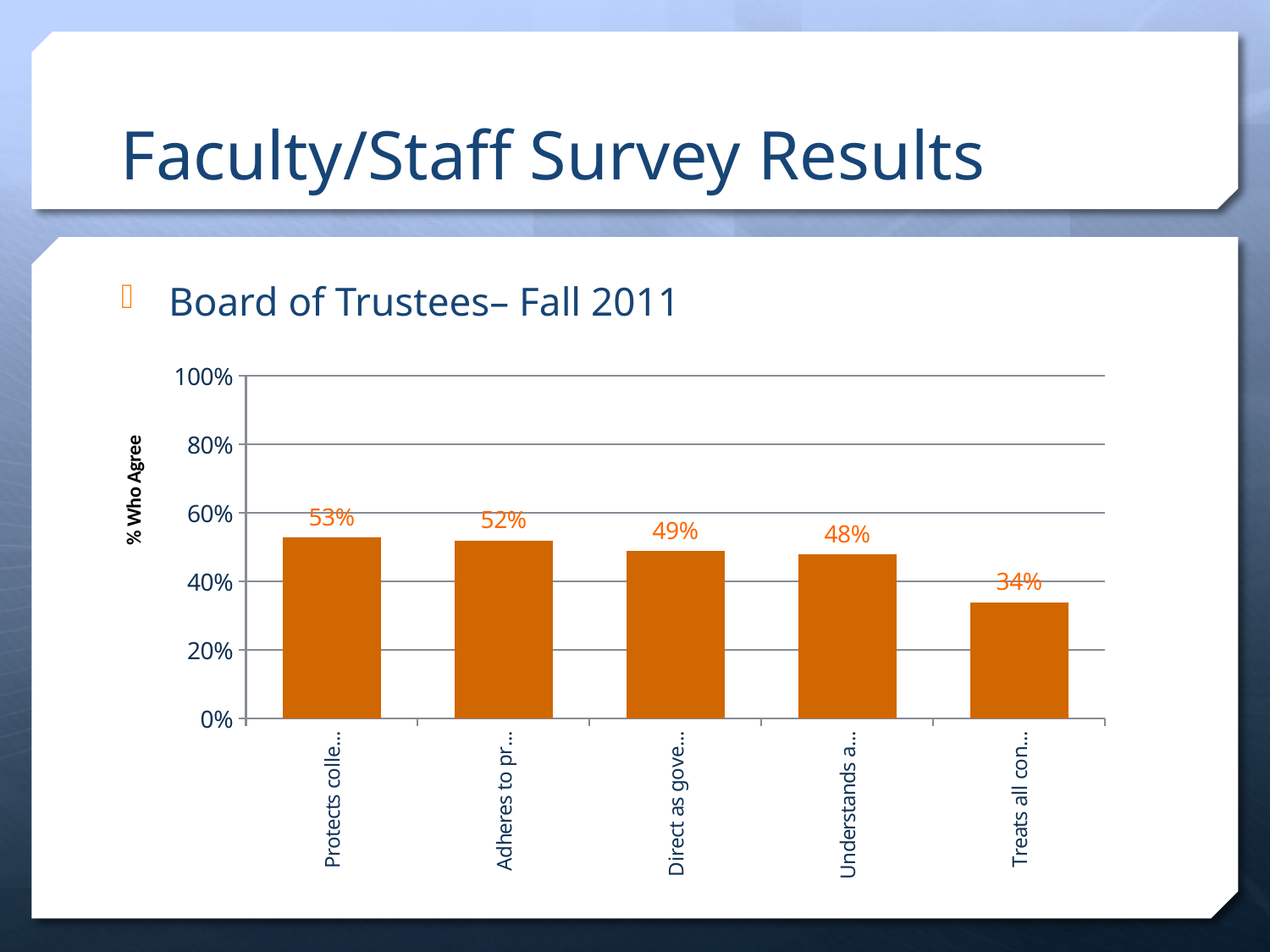
Which item has the highest percentage of agreement? Protects colle… Which item has the lowest percentage of agreement? Treats all con… How many bars are plotted in the chart? 5 Which is larger, the value for "Understands a…" or the value for "Treats all con…"? Understands a… What is the label on the vertical axis of the chart? % Who Agree What is the difference between the values for "Adheres to pr…" and "Understands a…"? 4% What is the difference between the values for "Protects colle…" and "Treats all con…"? 19% What is the value shown for the bar labelled "Direct as gove…"? 49% What is the value shown for the bar labelled "Treats all con…"? 34% Is the value for "Direct as gove…" greater or less than 60%? less What percentage of respondents agree with the item labelled "Protects colle…"? 53% What kind of chart is shown on the slide? Bar chart